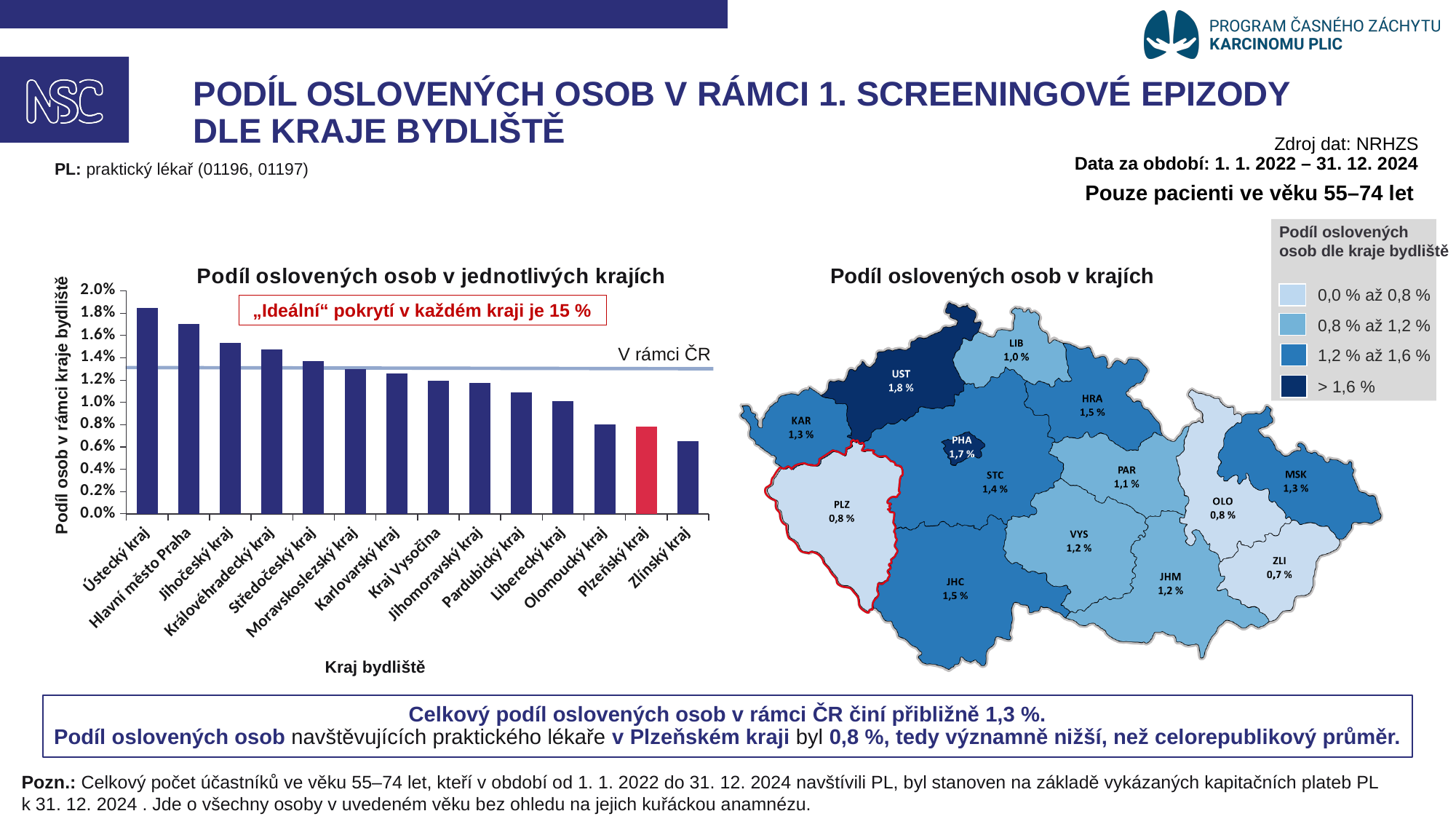
In the bar chart "Podíl oslovených osob v jednotlivých krajích", is the value for Ústecký kraj greater or less than 1.6%? greater In the bar chart "Podíl oslovených osob v jednotlivých krajích", which region has the highest bar? Ústecký kraj In the bar chart "Podíl oslovených osob v jednotlivých krajích", how many regions (kraje) are shown on the x axis? 14 In the bar chart "Podíl oslovených osob v jednotlivých krajích", do the values rise or fall from left to right along the x axis? fall In the bar chart "Podíl oslovených osob v jednotlivých krajích", which region's bar is coloured red? Plzeňský kraj In the bar chart "Podíl oslovených osob v jednotlivých krajích", is the value for Zlínský kraj greater or less than 0.8%? less In the bar chart "Podíl oslovených osob v jednotlivých krajích", which region has the lowest bar? Zlínský kraj In the map "Podíl oslovených osob v krajích", what value is shown for PLZ? 0,8 % In the map "Podíl oslovených osob v krajích", what value is shown for UST? 1,8 % What kind of chart is "Podíl oslovených osob v jednotlivých krajích"? bar chart In the map "Podíl oslovených osob v krajích", which has the larger value, HRA or LIB? HRA In the map "Podíl oslovených osob v krajích", what is the difference between the values for UST and ZLI? 1,1 %